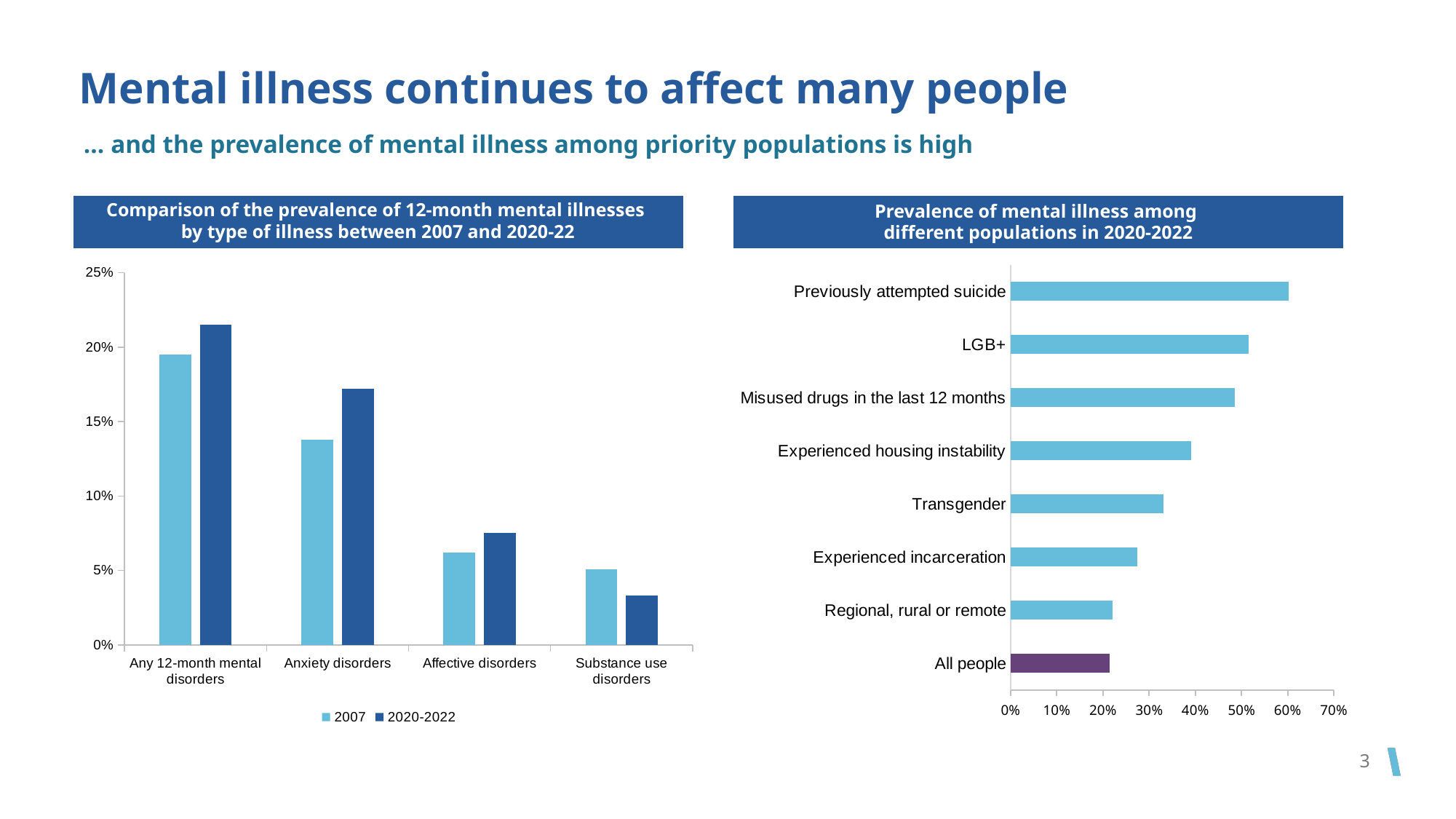
In the right chart, how many population groups are shown? 8 In the right chart, which population group's bar is shown in a different colour (purple) from the others? All people In the left chart, how many types of illness are shown on the x axis? 4 In the left chart, which type of illness has the highest 2020-2022 value? Any 12-month mental disorders What kind of chart is the left chart, 'Comparison of the prevalence of 12-month mental illnesses by type of illness between 2007 and 2020-22'? Bar chart What kind of chart is the right chart, 'Prevalence of mental illness among different populations in 2020-2022'? Bar chart In the left chart, is the 2007 value for Affective disorders greater or less than 10%? less In the left chart, for Substance use disorders, which is larger: the 2007 value or the 2020-2022 value? 2007 In the left chart, is the 2020-2022 value for Anxiety disorders greater or less than 15%? greater In the left chart, how many series does the legend list? 2 In the right chart, is the value for Transgender greater or less than 30%? greater In the right chart, which population group has the highest prevalence? Previously attempted suicide